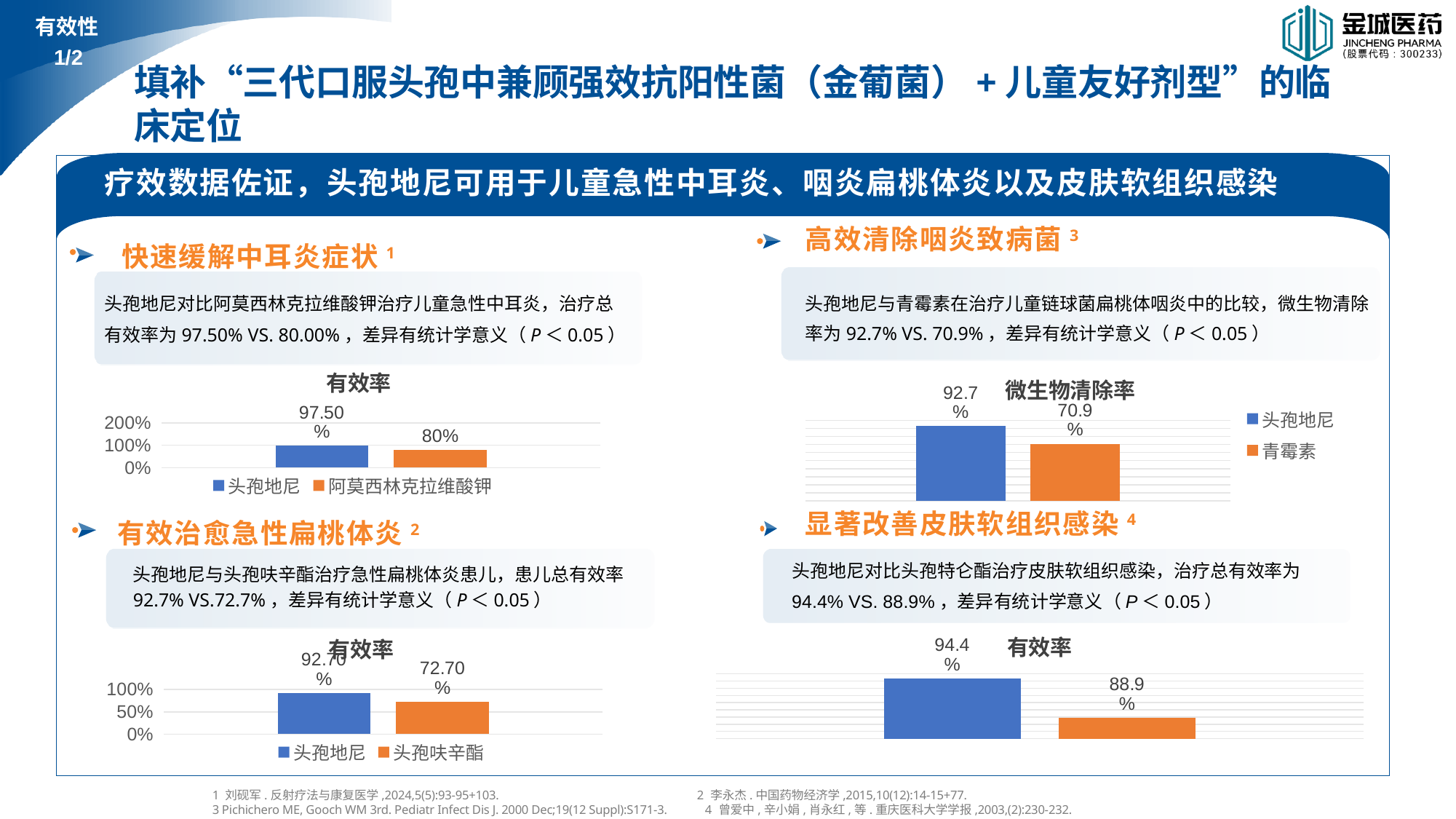
In the top-left chart (有效率), what is the difference between the 头孢地尼 and 阿莫西林克拉维酸钾 values? 17.50% In the bottom-left chart (有效率), what is the value for 头孢呋辛酯? 72.70% In the top-right chart (微生物清除率), how many series does the legend list? 2 What type of chart is the top-left chart (有效率)? Bar chart In the top-right chart (微生物清除率), what is the value for 青霉素? 70.9% In the bottom-left chart (有效率), what is the value for 头孢地尼? 92.70% In the bottom-right chart (有效率), what is the value of the blue bar (头孢地尼)? 94.4% In the bottom-right chart (有效率), what is the value of the orange bar? 88.9% In the top-left chart (有效率), what is the value for 阿莫西林克拉维酸钾? 80% In the bottom-left chart (有效率), is the value for 头孢呋辛酯 greater or less than 50%? greater In the top-left chart (有效率), what is the value for 头孢地尼? 97.50% In the top-right chart (微生物清除率), which series has the higher value, 头孢地尼 or 青霉素? 头孢地尼